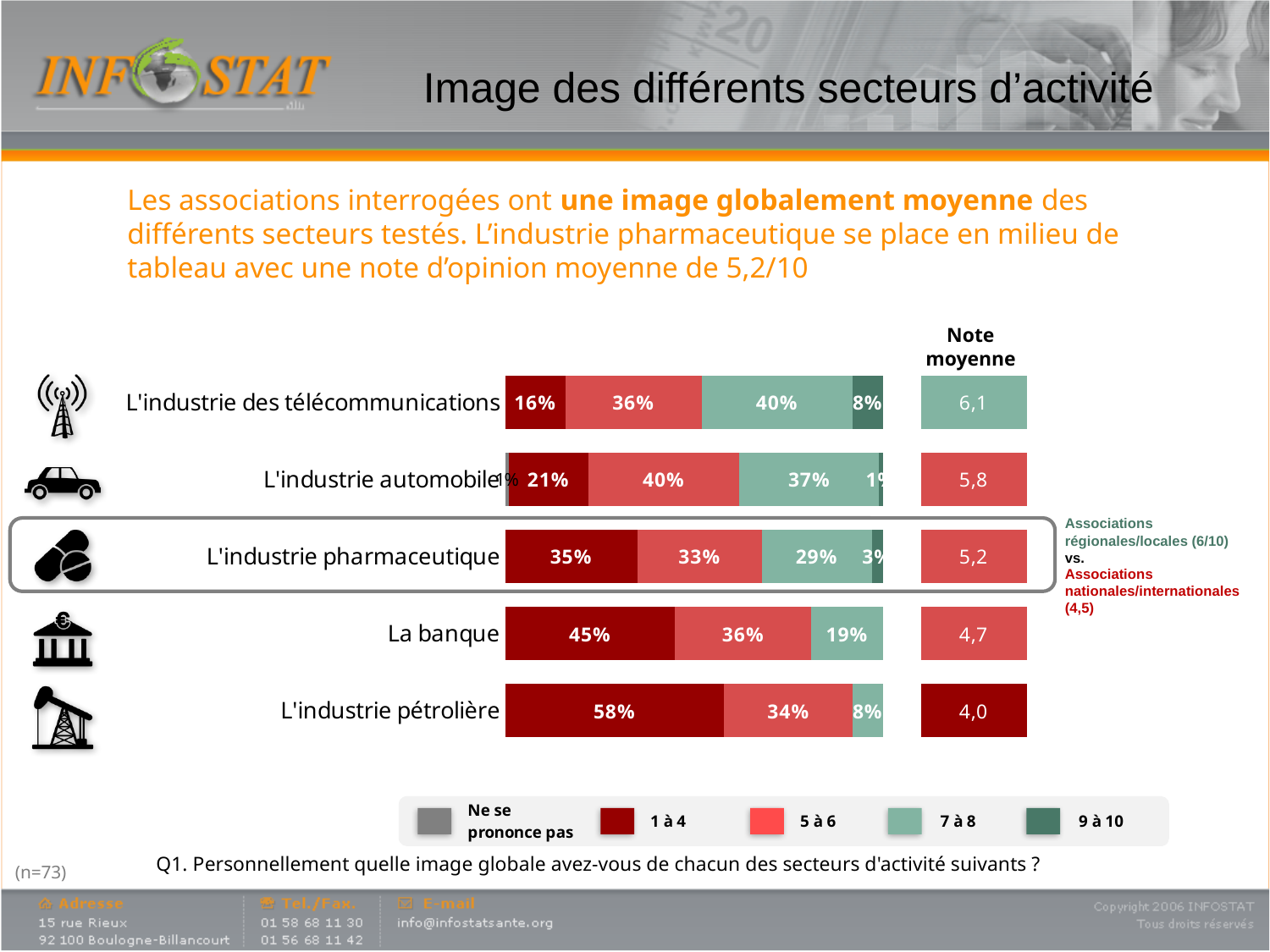
What is the '7 à 8' share for L'industrie des télécommunications? 40% Which sector has the largest '1 à 4' share? L'industrie pétrolière Which sector has the lowest 'Note moyenne'? L'industrie pétrolière What is the '5 à 6' share for La banque? 36% Which is larger: the '7 à 8' share for L'industrie automobile or for L'industrie pharmaceutique? L'industrie automobile How many series does the chart legend list? 5 What is the 'Note moyenne' for L'industrie pharmaceutique? 5,2 What kind of chart is shown on the slide? Stacked bar chart What is the '1 à 4' share for L'industrie pétrolière? 58% Which sector has the highest 'Note moyenne'? L'industrie des télécommunications How many sectors (categories) are plotted in the chart? 5 What is the difference between the '1 à 4' share of La banque and that of L'industrie pharmaceutique? 10%